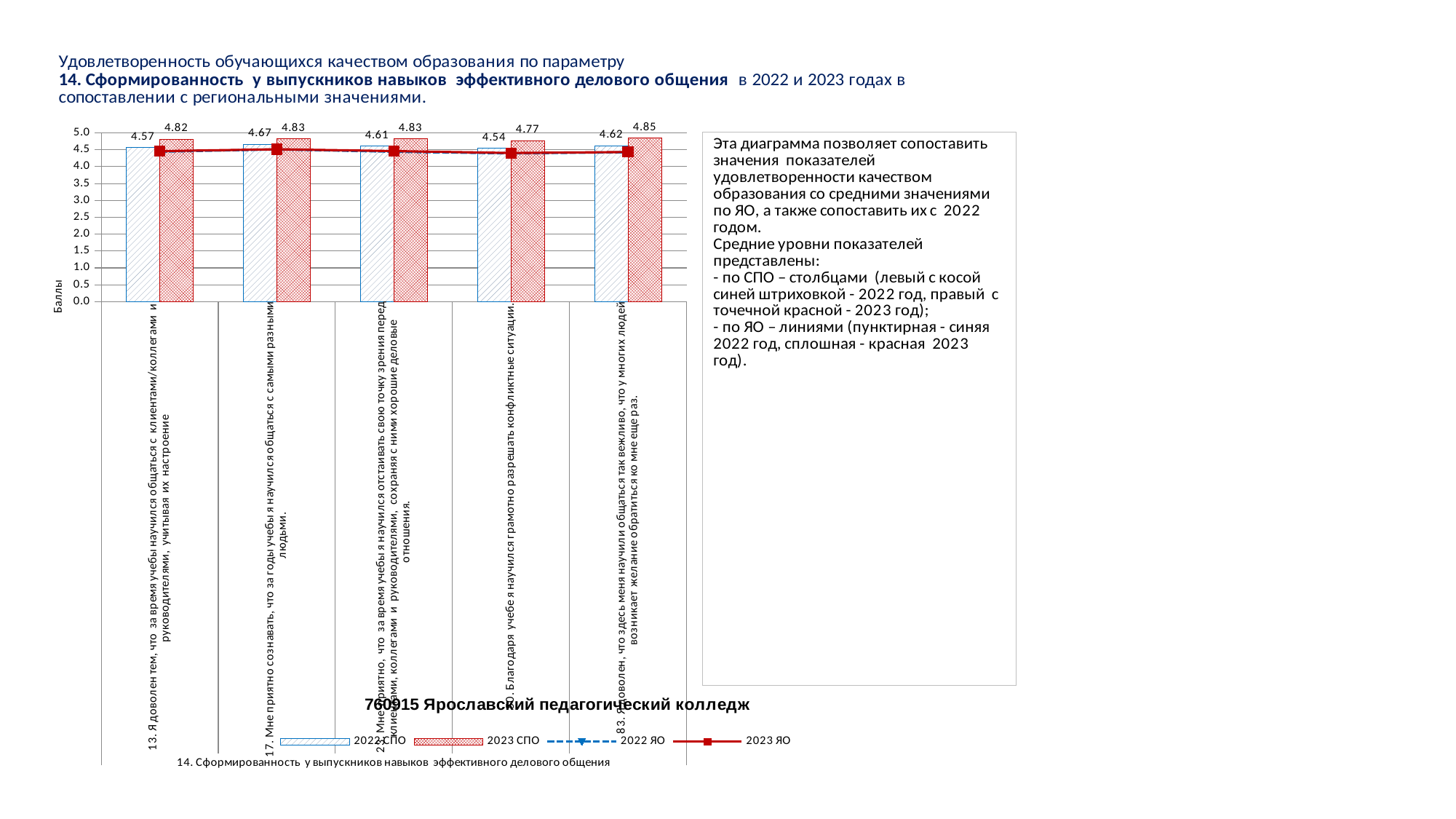
What is the title of the vertical axis of the chart? Баллы How many series does the chart legend list? 4 What is the 2023 СПО value for category 83 ("Я доволен, что здесь меня научили общаться так вежливо...")? 4.85 How many categories are shown on the x axis of the chart? 5 What is the 2022 СПО value for the category about resolving conflict situations ("Благодаря учебе я научился грамотно разрешать конфликтные ситуации")? 4.54 Is the 2023 ЯО line value for category 13 greater or less than 4.0? greater By how much does the 2023 СПО value exceed the 2022 СПО value for category 13? 0.25 Which category has the lowest 2022 СПО value? Благодаря учебе я научился грамотно разрешать конфликтные ситуации (4.54) For category 17, which is larger: the 2022 СПО value or the 2023 СПО value? 2023 СПО What is the 2022 СПО value for category 17 ("Мне приятно сознавать, что за годы учебы я научился общаться с самыми разными людьми")? 4.67 Which category has the highest 2023 СПО value? 83. Я доволен, что здесь меня научили общаться так вежливо, что у многих людей возникает желание обратиться ко мне еще раз (4.85) What is the 2023 СПО value for category 13 ("Я доволен тем, что за время учебы научился общаться с клиентами/коллегами и руководителями...")? 4.82